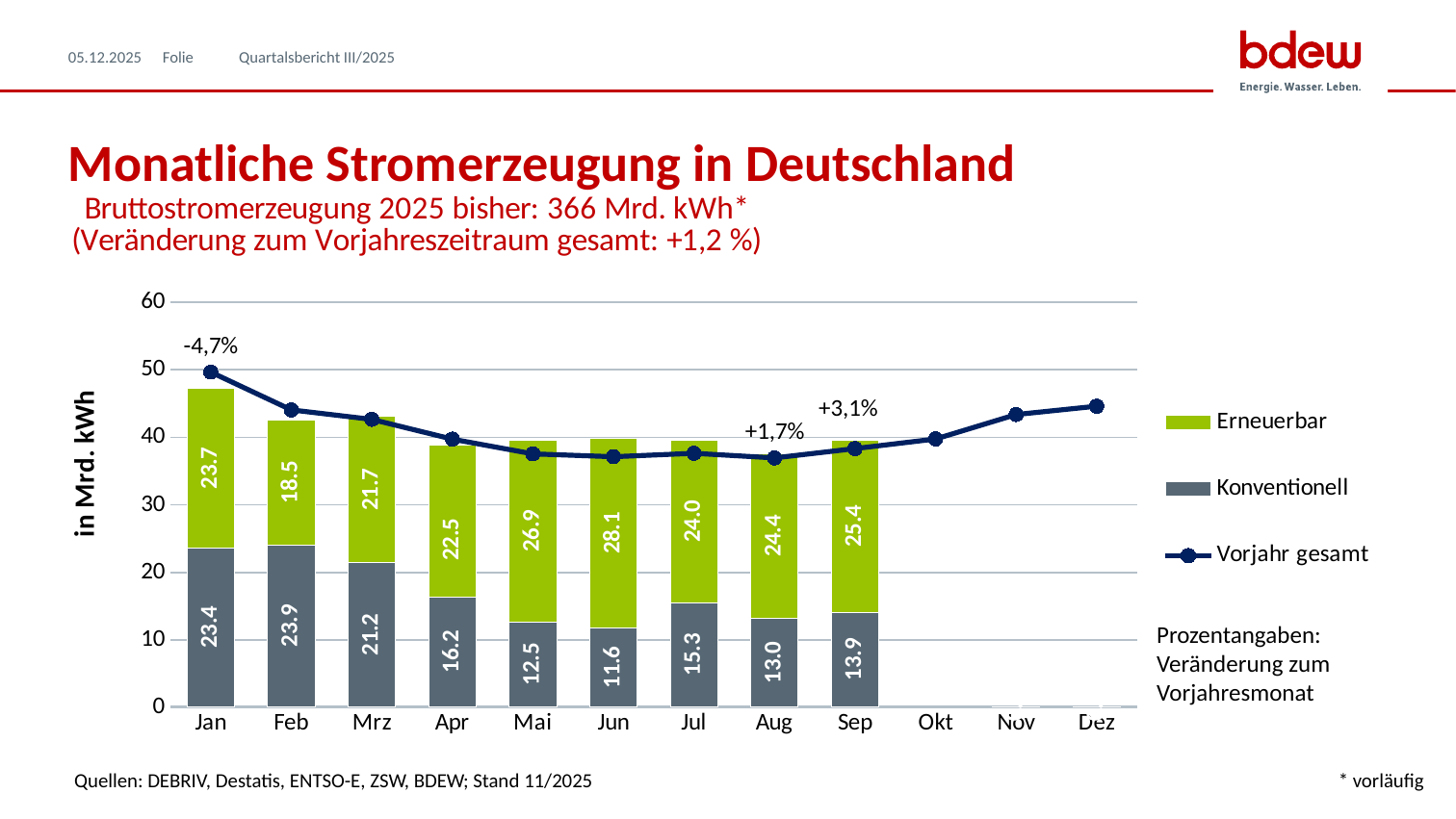
Which month has the highest Erneuerbar value? Jun How many months have stacked bars plotted? 9 What is the total of the stacked bar for Jan? 47.1 What is the Konventionell value for Feb? 23.9 What is the difference between the Erneuerbar values for Sep and Aug? 1.0 How many series does the legend list? 3 Which is larger, the Konventionell value for Jan or for Mrz? Jan What percentage change is shown above the Sep bar? +3,1% Which month has the lowest Konventionell value? Jun What is the Erneuerbar value for Jun? 28.1 What kind of chart is shown? Stacked bar chart with a line Is the Vorjahr gesamt value for Jan greater or less than 40? greater